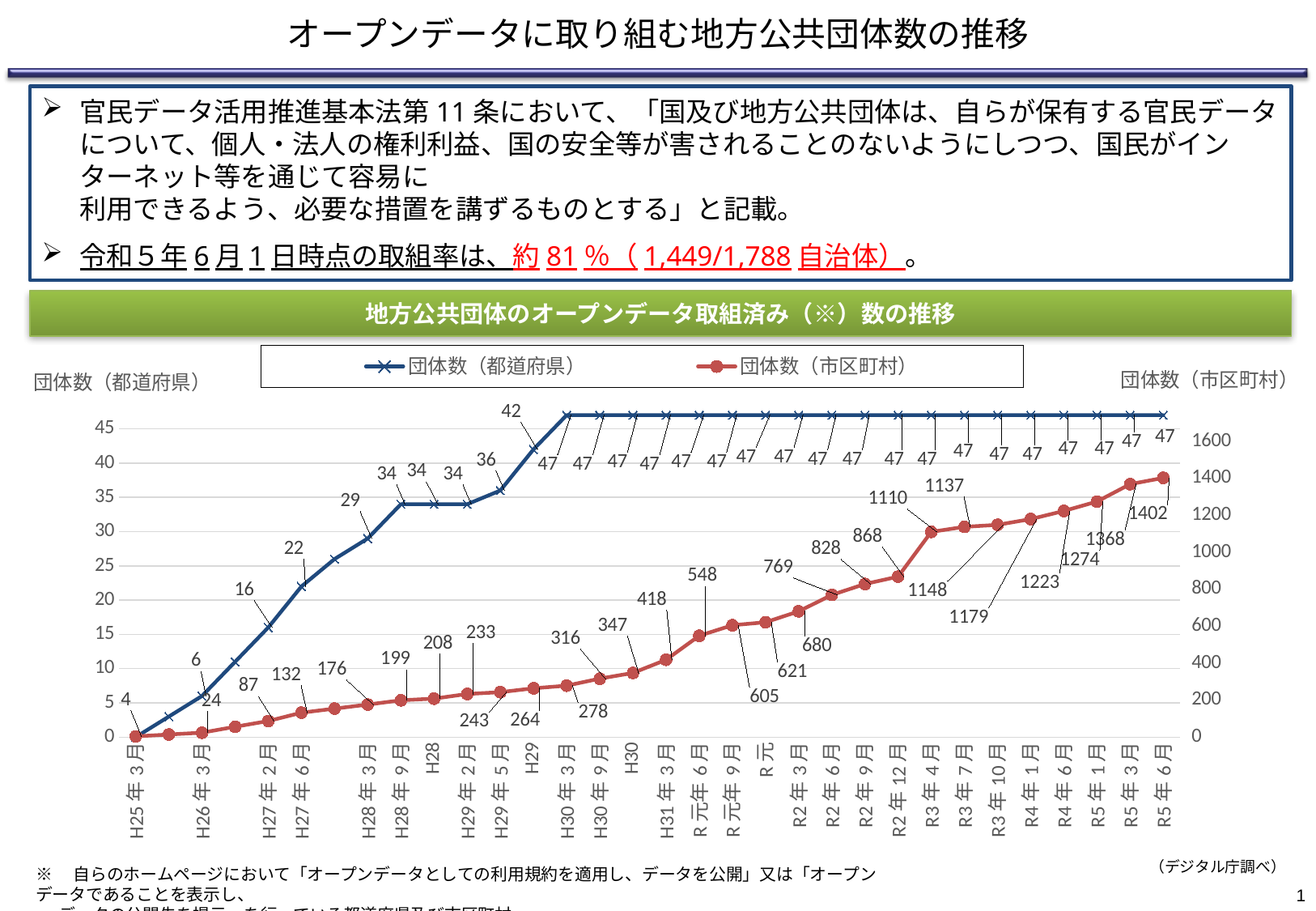
What is the value of 団体数（都道府県） at H27年6月? 22 What are the two series named in the chart legend? 団体数（都道府県） and 団体数（市区町村） What is the value of 団体数（都道府県） at H25年3月? 0 What is the value of 団体数（都道府県） at H29年5月? 36 What is the highest value reached by the 団体数（都道府県） series? 47 What is the value of 団体数（都道府県） at R5年6月? 47 How many series does the chart legend list? 2 What kind of chart is shown on the slide? line chart Is the value of 団体数（市区町村） at R5年6月 greater or less than 1200? greater Which is larger for 団体数（都道府県）: the value at H27年6月 or at H28年3月? H28年3月 What is the value of 団体数（市区町村） at R3年4月? 1110 What is the difference between the 団体数（都道府県） values at R5年6月 and H25年3月? 47